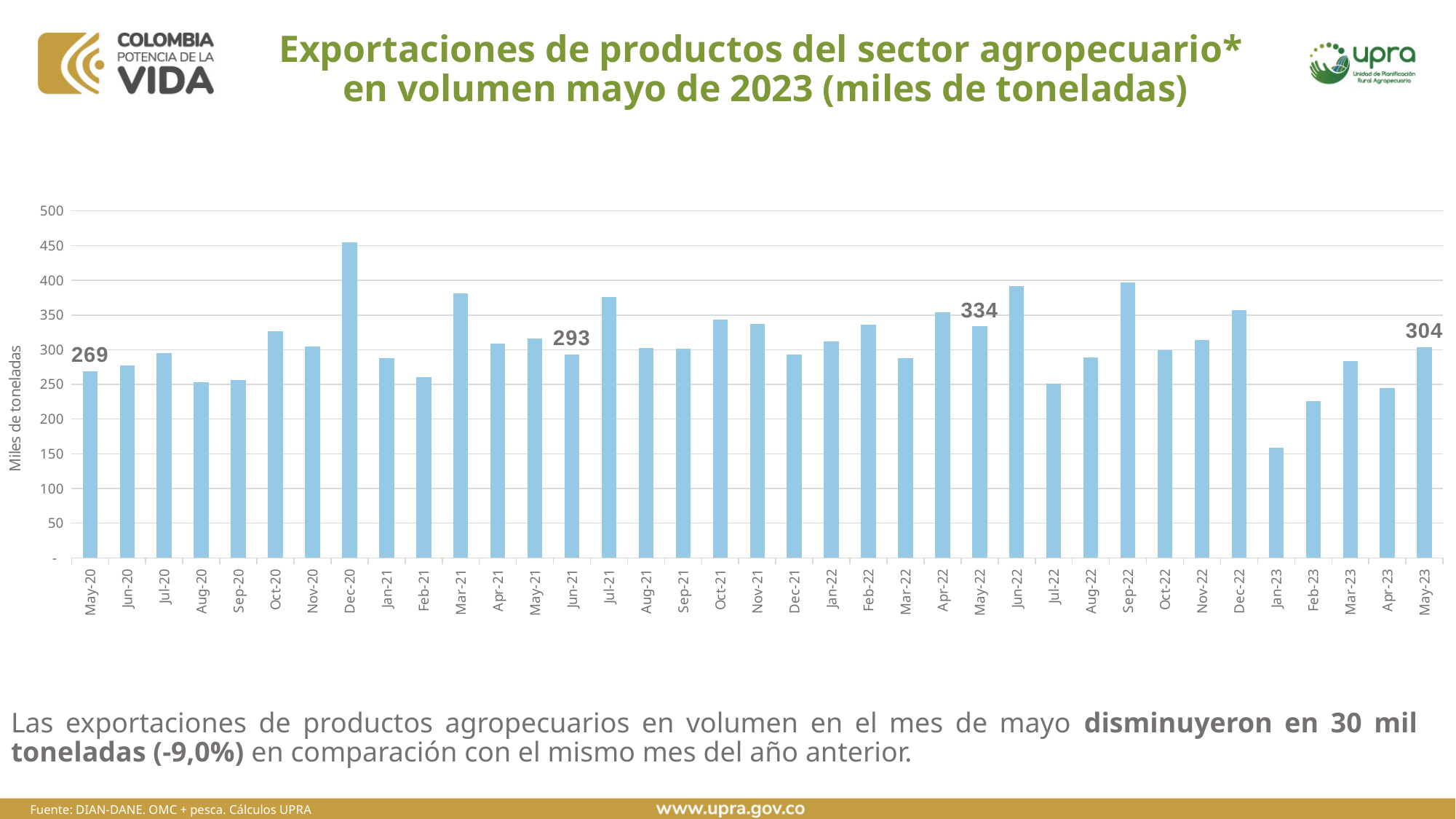
What is the label on the vertical axis? Miles de toneladas Which month has the highest bar? Dec-20 Is the value for Jan-23 greater or less than 200? less Is the value for Dec-20 greater or less than 400? greater What is the value for May-20? 269 What is the value for Jun-21? 293 What is the value for May-22? 334 Which month has the lowest bar? Jan-23 What type of chart is shown on the slide? bar chart What is the value for May-23? 304 What is the difference between the values for May-22 and May-23? 30 Which is larger, the value for May-22 or the value for May-23? May-22